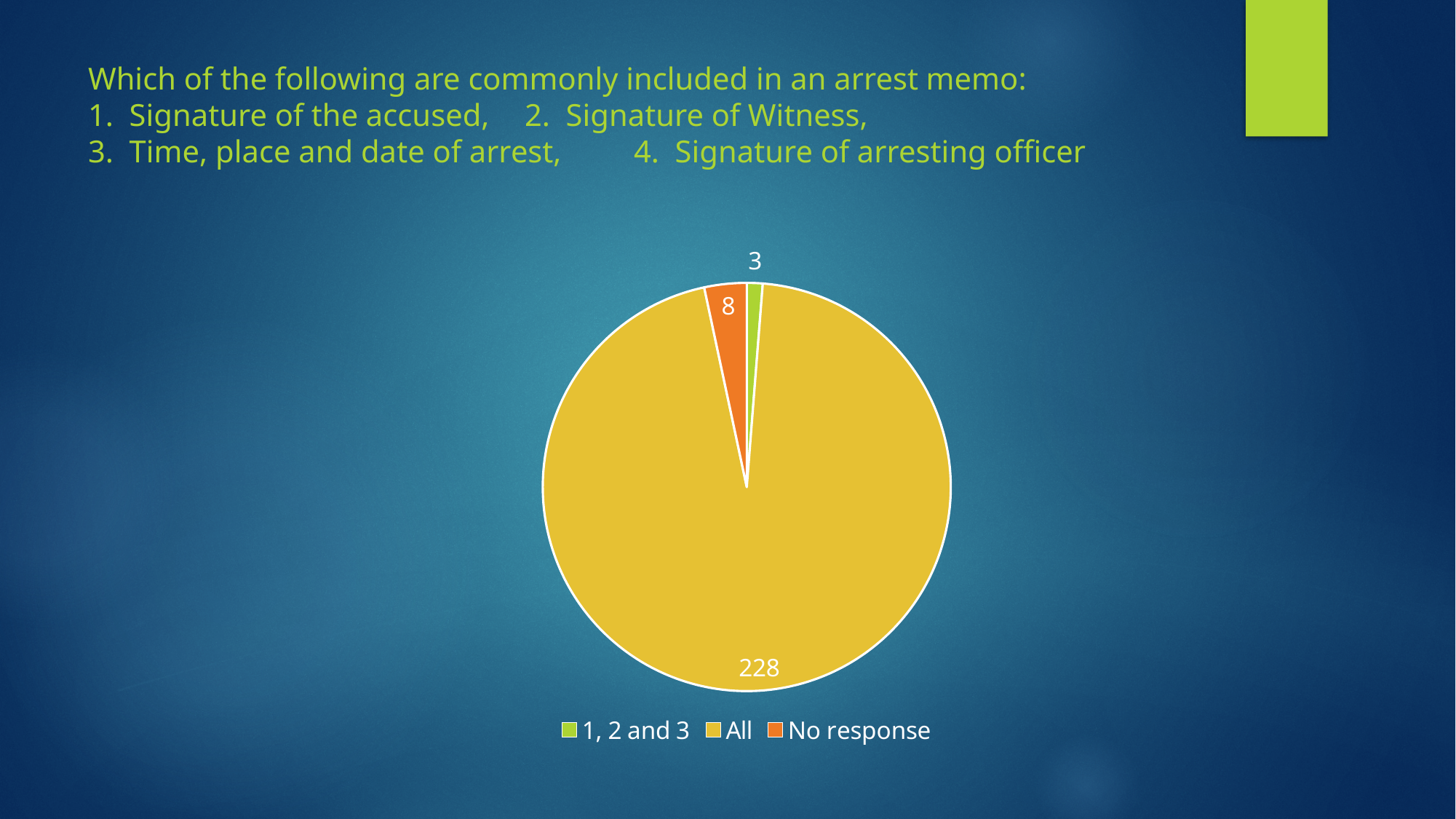
What type of chart is shown on the slide? pie chart How many respondents answered "All"? 228 What is the difference between the number of "All" responses and the number of "No response" answers? 220 What colour is the "All" slice in the pie chart? yellow Which category has the smallest slice of the pie? 1, 2 and 3 What is the difference between the "No response" count and the "1, 2 and 3" count? 5 How many categories does the pie chart show? 3 Which category has the largest slice of the pie? All What is the total number of responses across all slices of the pie? 239 Which is larger, the "No response" slice or the "1, 2 and 3" slice? No response How many respondents answered "1, 2 and 3"? 3 How many respondents gave "No response"? 8